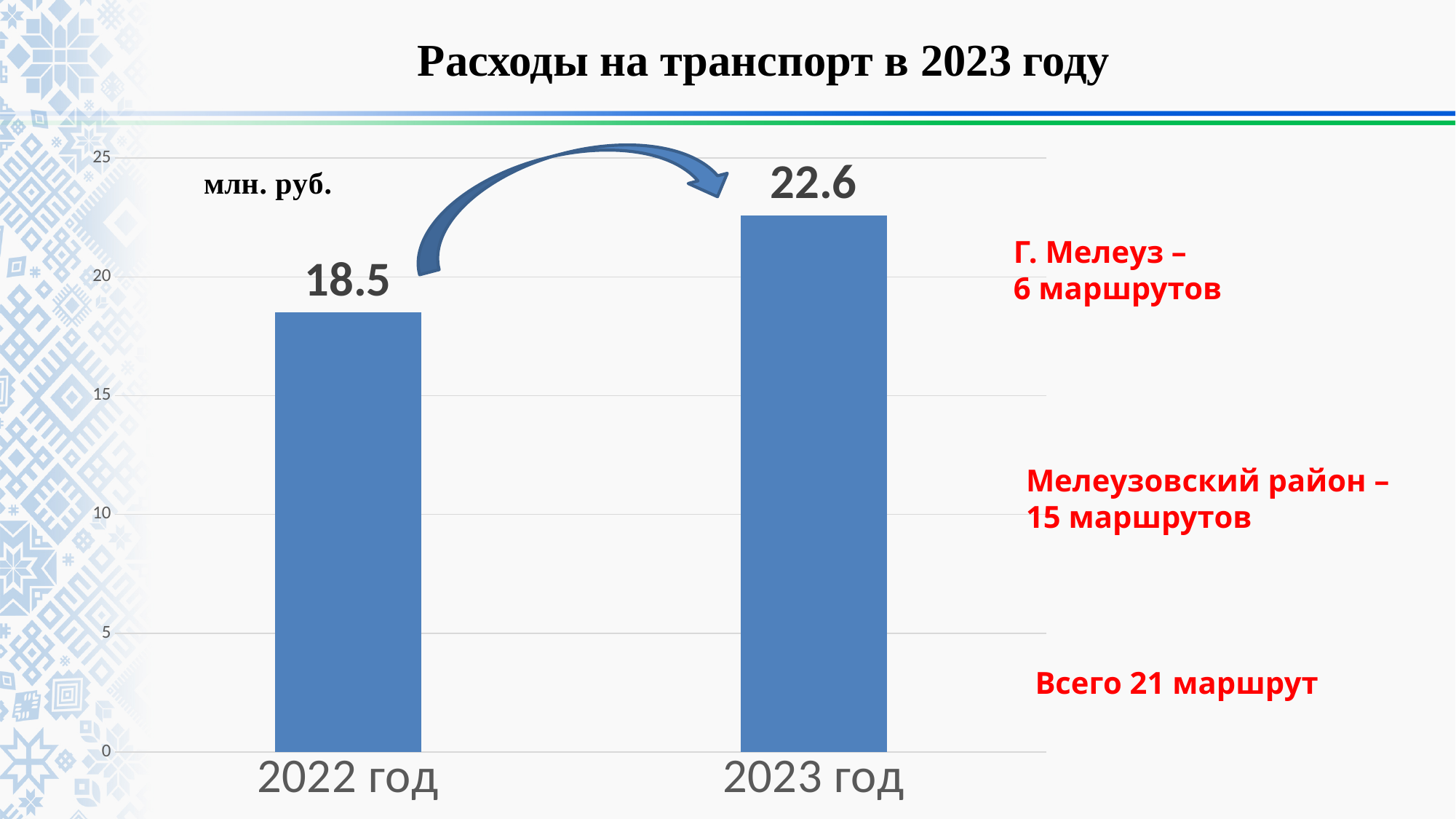
How many bars are shown in the chart? 2 Is the value for 2022 год greater or less than 20? less Which year has the lower transport expenditure? 2022 год What unit is indicated for the values in the chart? млн. руб. What is the value for 2022 год? 18.5 Is the value for 2023 год greater or less than 20? greater What is the difference between the values for 2023 год and 2022 год? 4.1 Do the values rise or fall from 2022 год to 2023 год? rise Is the value for 2022 год larger or smaller than the value for 2023 год? smaller Which year has the higher transport expenditure? 2023 год What is the value for 2023 год? 22.6 What kind of chart is shown on the slide? bar chart